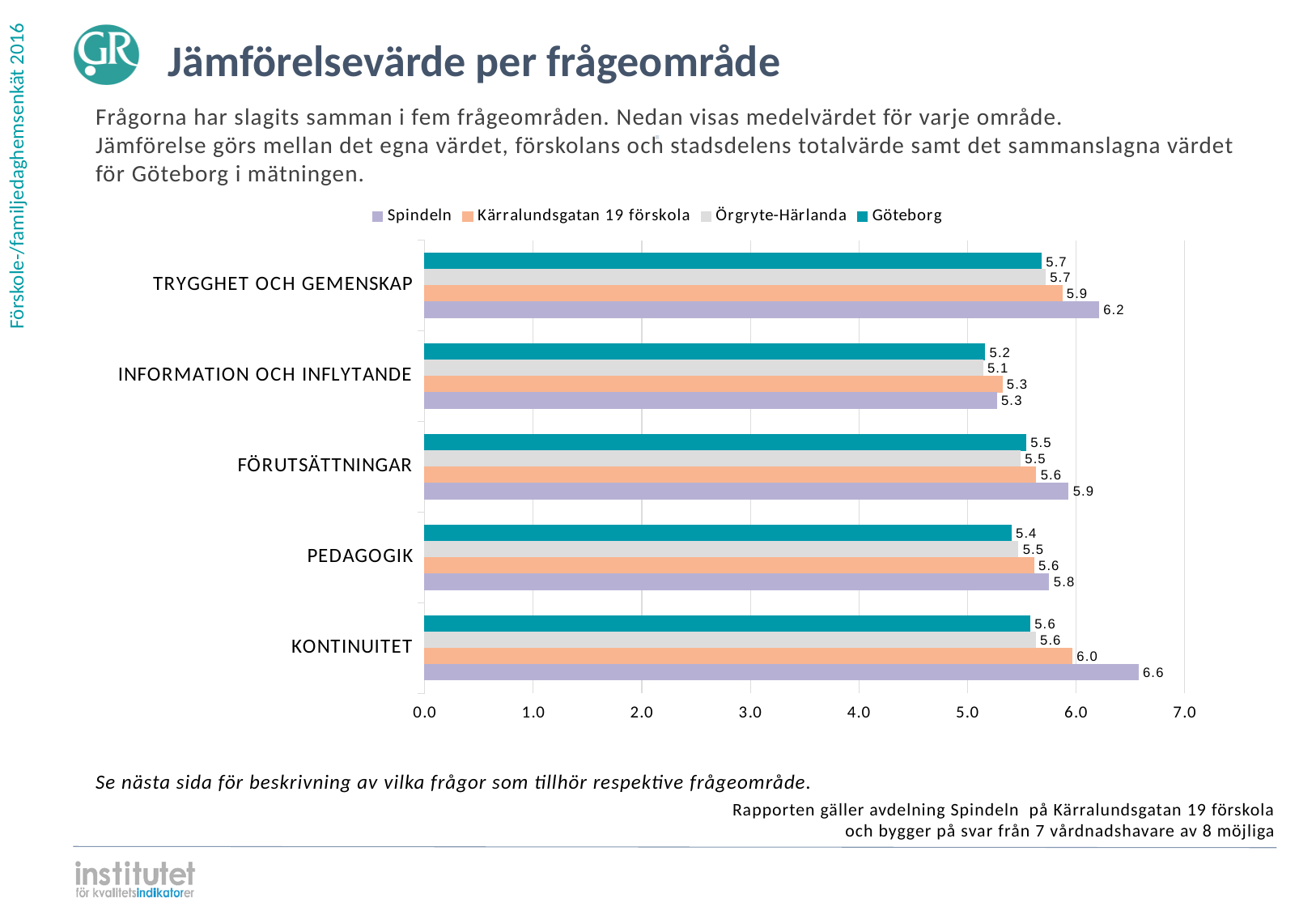
What is the value for Göteborg in the INFORMATION OCH INFLYTANDE category? 5.2 In which category does Spindeln have its lowest value? INFORMATION OCH INFLYTANDE How many question areas (categories) are shown on the chart? 5 What is the value for Örgryte-Härlanda in the TRYGGHET OCH GEMENSKAP category? 5.7 Which is larger in the FÖRUTSÄTTNINGAR category: the Spindeln value or the Kärralundsgatan 19 förskola value? Spindeln What is the difference between the Spindeln value and the Göteborg value in the KONTINUITET category? 1.0 In which category does Spindeln have its highest value? KONTINUITET What is the maximum value shown on the horizontal axis? 7.0 What kind of chart is shown on the slide? Bar chart What is the value for Spindeln in the KONTINUITET category? 6.6 What is the value for Kärralundsgatan 19 förskola in the PEDAGOGIK category? 5.6 How many series does the legend list? 4